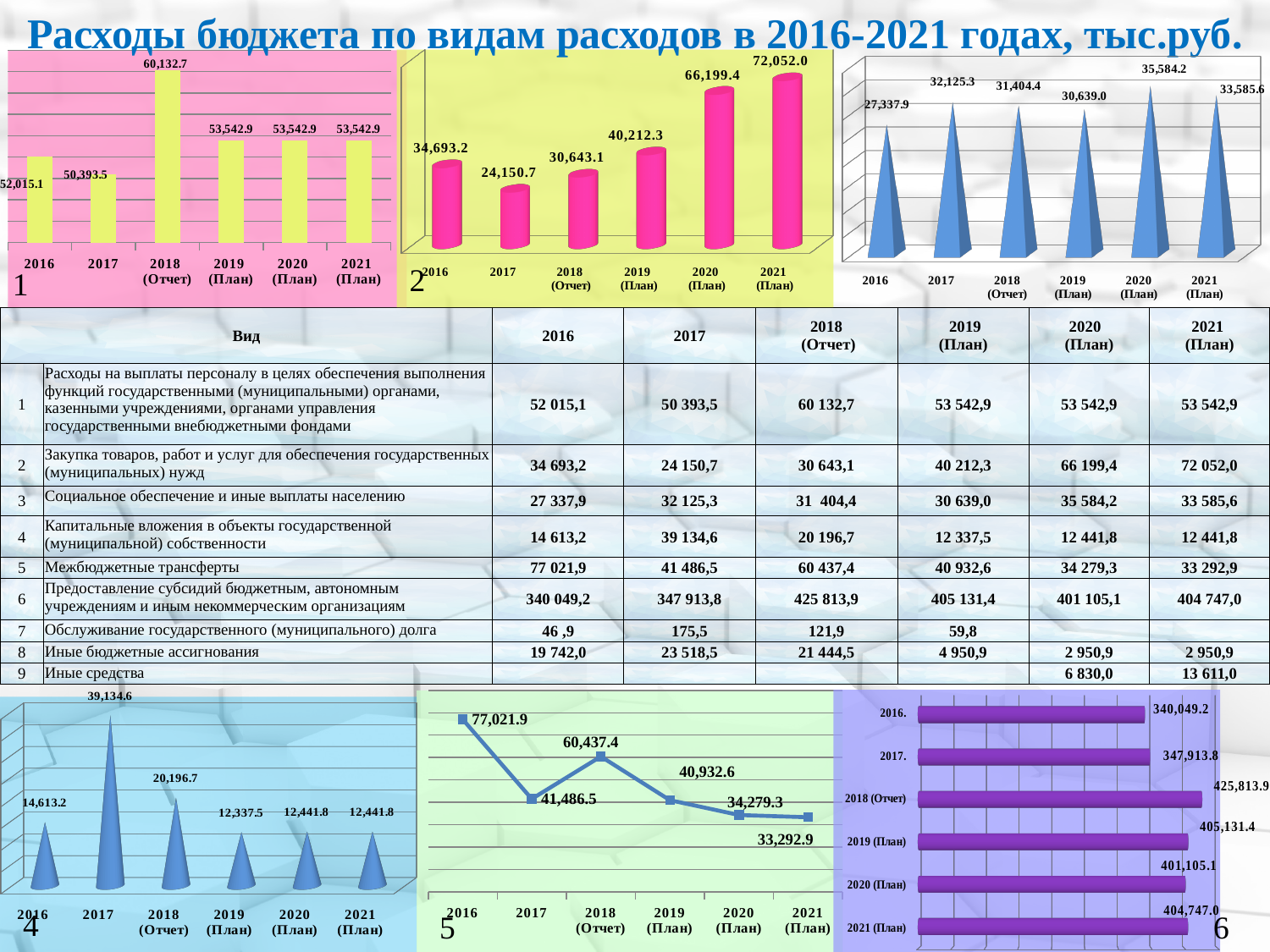
In the top-right chart (chart 3), which is larger, the value for 2017 or the value for 2019 (План)? 2017 In the top-right chart (chart 3), what is the value for 2020 (План)? 35,584.2 In the top-left chart (chart 1), which year has the highest value? 2018 (Отчет) In the top-left chart (chart 1), what is the value for 2018 (Отчет)? 60,132.7 In the bottom-left chart (chart 4), what is the value for 2017? 39,134.6 What type of chart is the bottom-middle chart (chart 5)? line chart In the top-middle chart (chart 2), which year has the lowest value? 2017 In the top-middle chart (chart 2), what is the difference between the 2021 (План) and 2020 (План) values? 5,852.6 In the bottom-middle chart (chart 5), what is the value for 2016? 77,021.9 In the top-middle chart (chart 2), what is the value for 2021 (План)? 72,052.0 In the bottom-right chart (chart 6), which year has the highest value? 2018 (Отчет) In the bottom-left chart (chart 4), how many years are plotted? 6